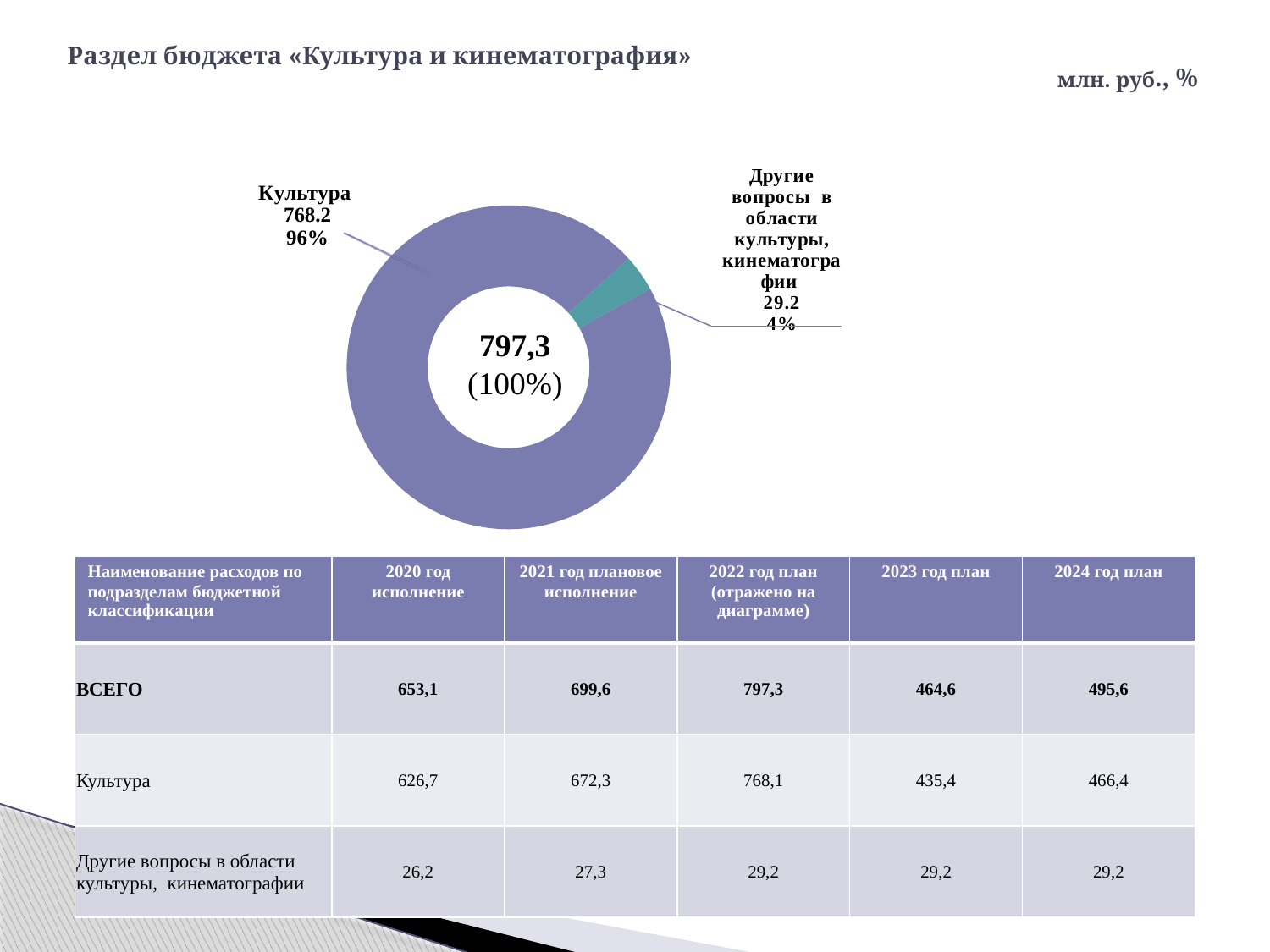
What kind of chart is shown on the slide? Pie (donut) chart What share of the donut chart does the slice Другие вопросы в области культуры, кинематографии represent? 4% What value is shown for the slice Другие вопросы в области культуры, кинематографии in the donut chart? 29.2 What share of the donut chart does the Культура slice represent? 96% Which slice of the donut chart is the smallest? Другие вопросы в области культуры, кинематографии How many slices does the donut chart have? 2 Which is larger in the donut chart: Культура or Другие вопросы в области культуры, кинематографии? Культура What is the difference between the Культура slice and the Другие вопросы в области культуры, кинематографии slice in the donut chart? 739.0 What value is shown for the Культура slice in the donut chart? 768.2 Which slice of the donut chart is the largest? Культура What total value is printed in the centre of the donut chart? 797,3 What colour is the Культура slice in the donut chart? Purple